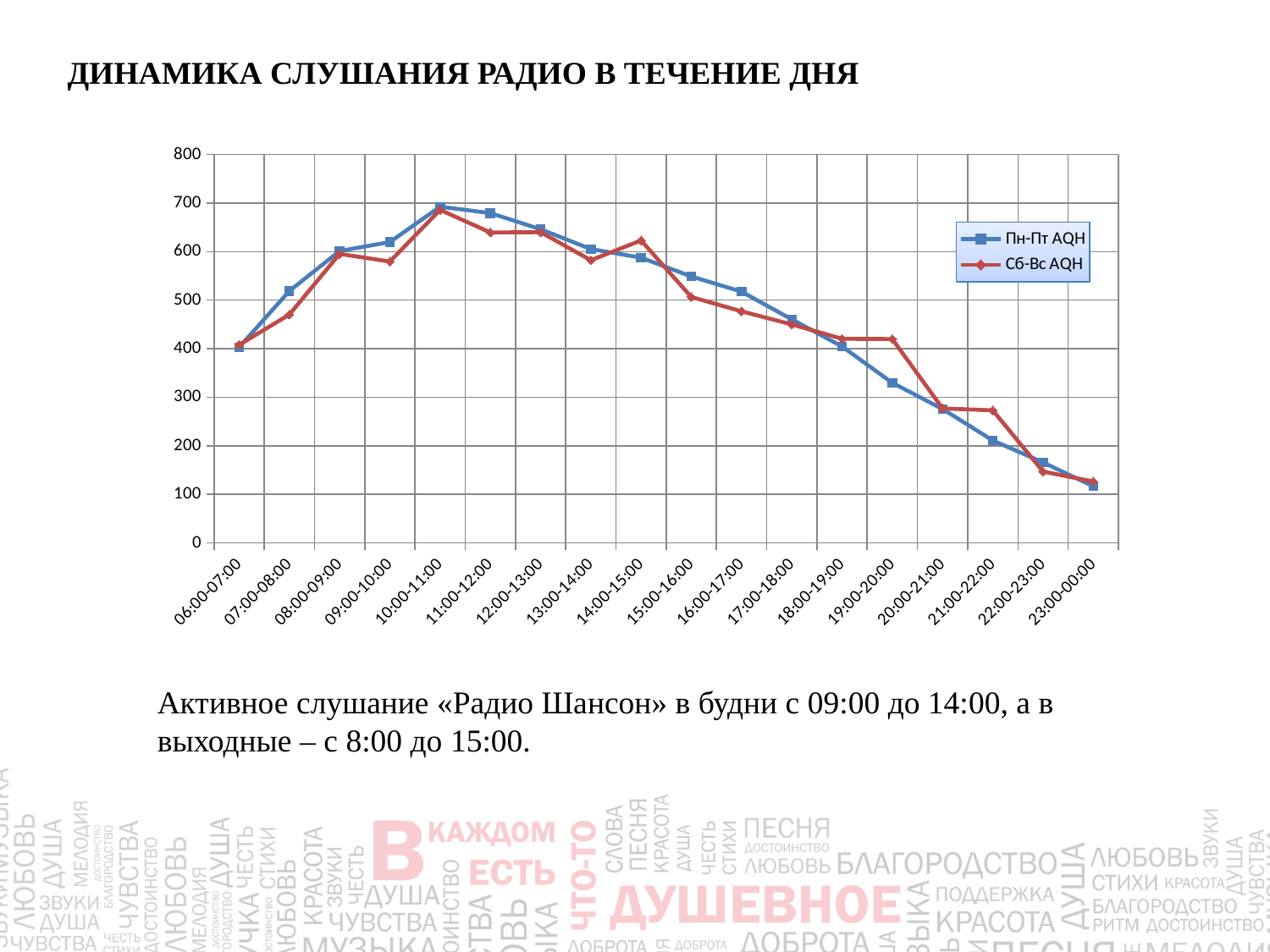
How many series does the legend list? 2 Which series has the higher value at 19:00-20:00, Пн-Пт AQH or Сб-Вс AQH? Сб-Вс AQH How many time intervals are plotted along the x axis? 18 In which time interval does the Сб-Вс AQH series reach its highest value? 10:00-11:00 In which time interval does the Пн-Пт AQH series reach its highest value? 10:00-11:00 Is the Пн-Пт AQH value for 19:00-20:00 greater or less than 400? less What kind of chart is shown on the slide? line chart In which time interval is the Пн-Пт AQH series at its lowest? 23:00-00:00 Is the Сб-Вс AQH value for 07:00-08:00 greater or less than 500? less What is the title of the slide above the chart? ДИНАМИКА СЛУШАНИЯ РАДИО В ТЕЧЕНИЕ ДНЯ Is the Пн-Пт AQH value for 07:00-08:00 greater or less than 500? greater Do the Пн-Пт AQH values rise or fall from 10:00-11:00 to 23:00-00:00? fall